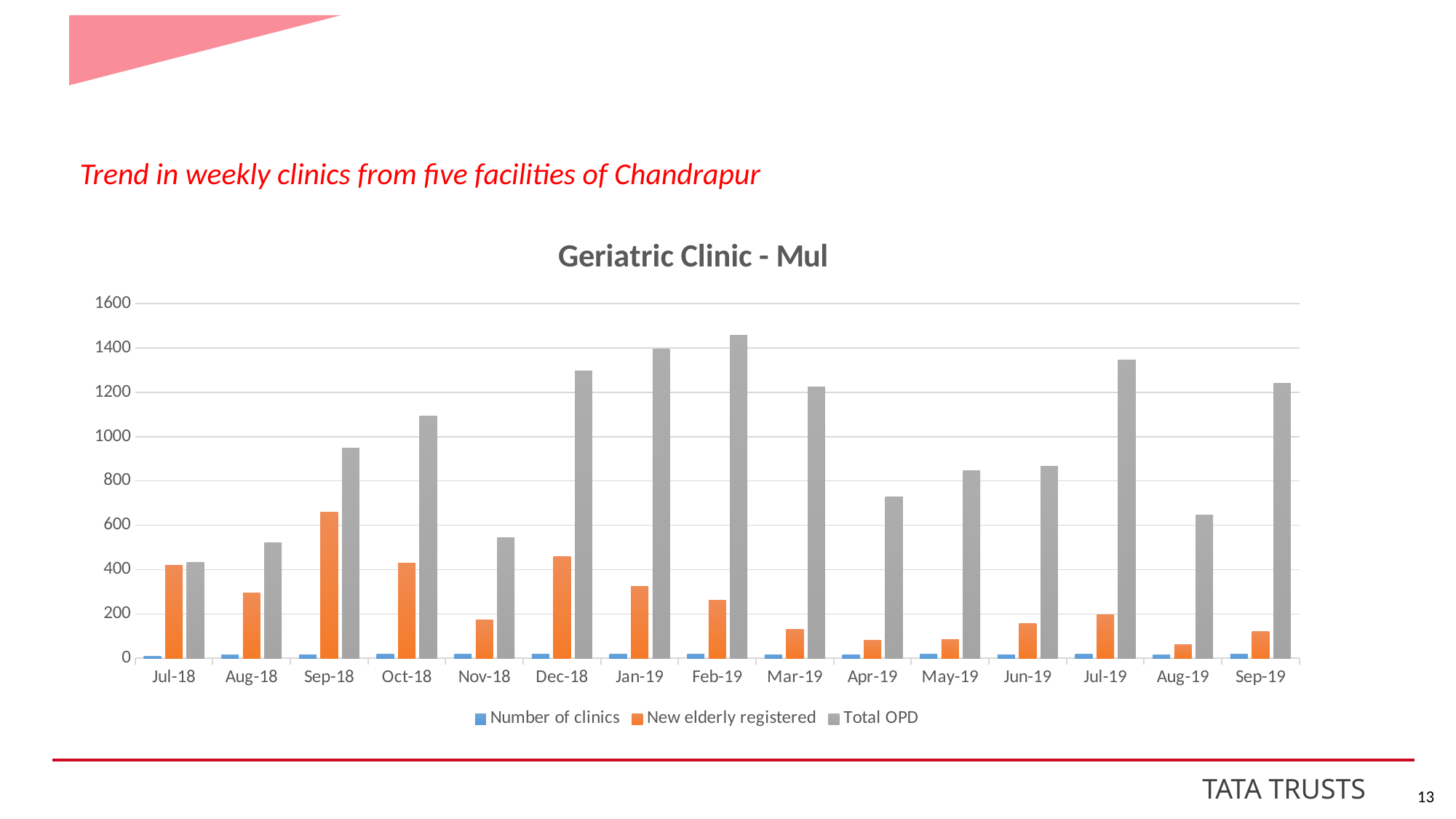
How many series does the legend list? 3 What is the title of the chart? Geriatric Clinic - Mul Which month has the highest number of New elderly registered? Sep-18 Which month has the lowest Total OPD? Jul-18 Does Total OPD rise or fall from Feb-19 to Apr-19? fall Which month has the highest Total OPD? Feb-19 Is the Total OPD value for Feb-19 greater or less than 1400? greater Is the Total OPD value for Apr-19 greater or less than 800? less What kind of chart is shown on the slide? Bar chart How many months are shown on the x axis? 15 Which month has the larger Total OPD, Jan-19 or Apr-19? Jan-19 Is the New elderly registered value for Sep-18 greater or less than 600? greater